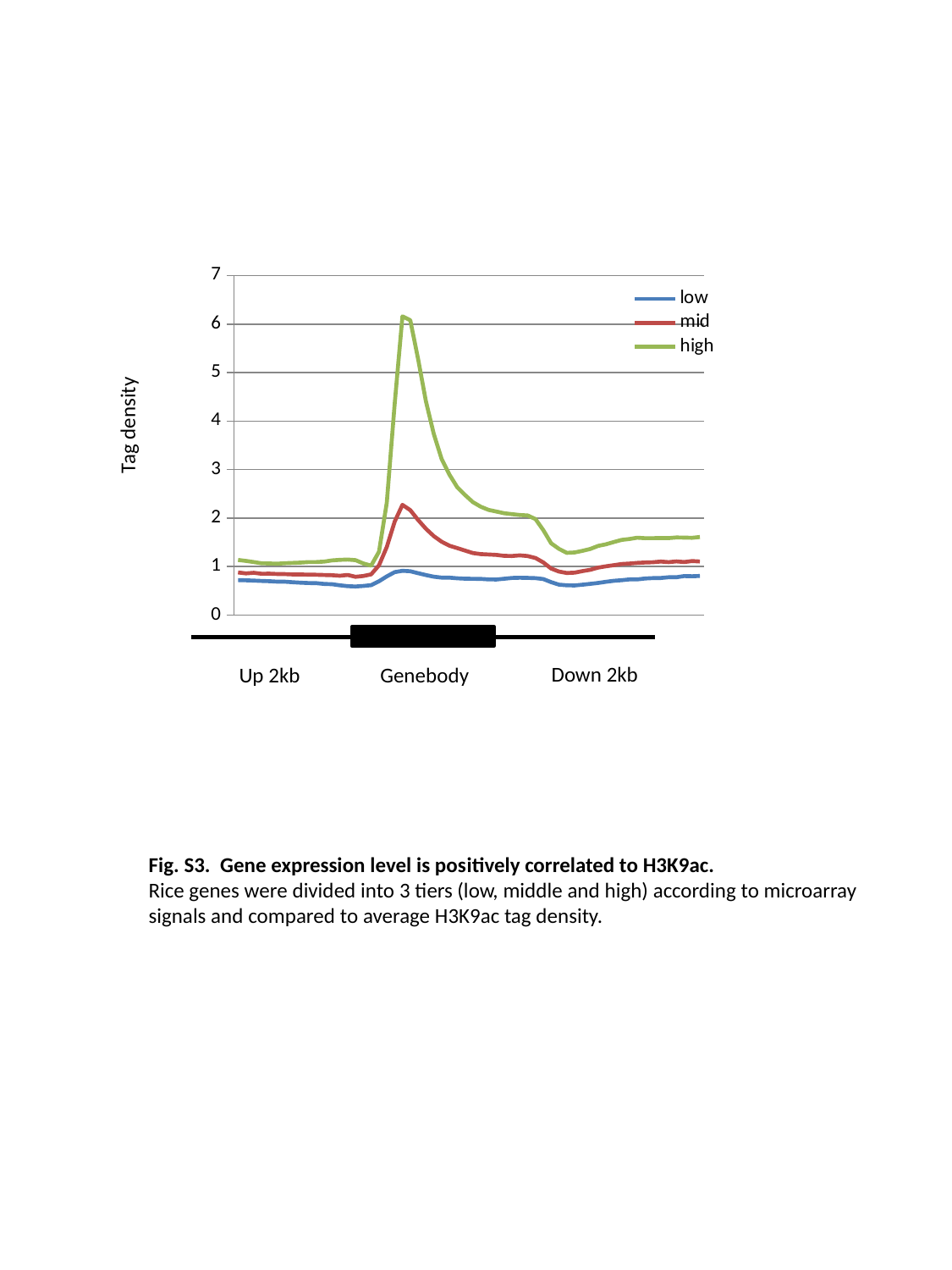
What kind of chart is shown on the slide? line chart Which series has the lowest tag density across the plotted region? low In which region of the x axis do all three series reach their peak? Genebody Which series reaches the highest tag density? high Is the peak value of the mid series greater or less than 2? greater What are the series names listed in the legend? low, mid, high How many series does the legend list? 3 Is the peak value of the low series greater or less than 2? less What is the label of the y axis? Tag density Is the peak value of the high series greater or less than 5? greater How many labelled regions are shown along the x axis? 3 Which series has a higher peak, mid or low? mid